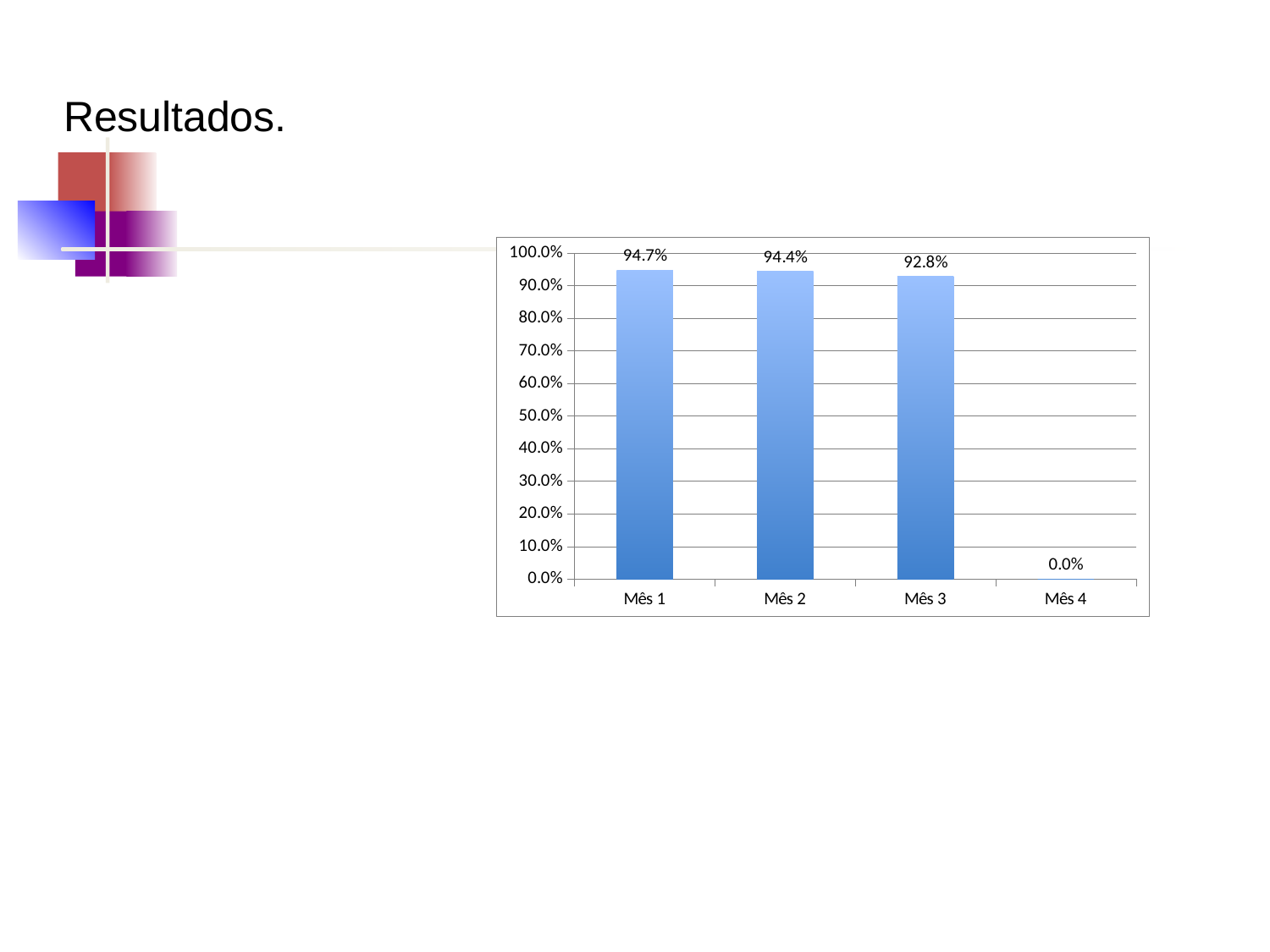
What is the value for Mês 2? 94.4% Which category has the lowest value? Mês 4 Do the values rise or fall from Mês 1 to Mês 4? Fall What kind of chart is shown on the slide? Bar chart Which category has the highest value? Mês 1 Which is larger, the value for Mês 2 or the value for Mês 3? Mês 2 What is the value for Mês 4? 0.0% Is the value for Mês 3 greater or less than 90.0%? greater What is the value for Mês 1? 94.7% What is the value for Mês 3? 92.8% What is the difference between the values for Mês 1 and Mês 3? 1.9% How many categories are shown on the x axis? 4